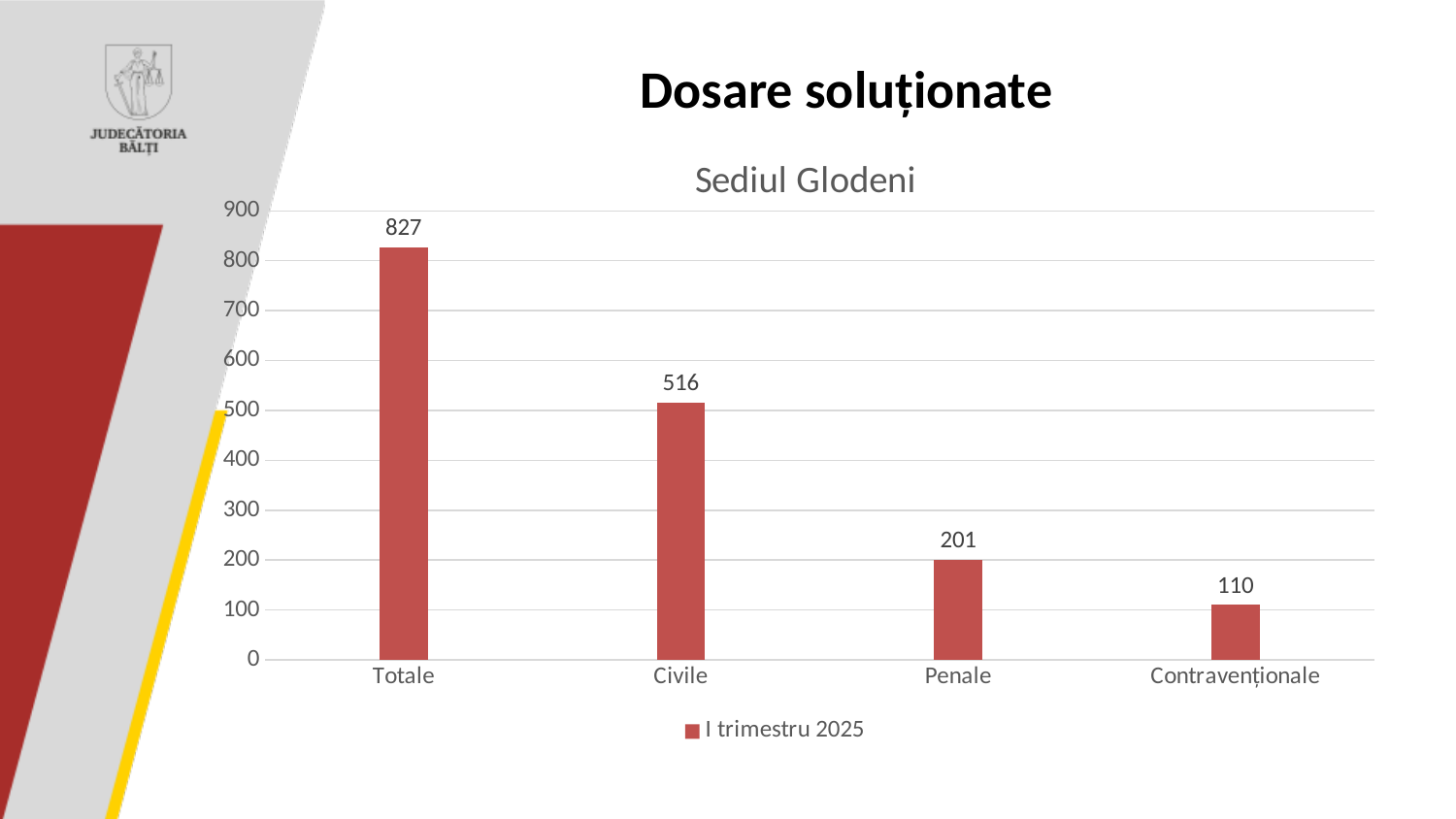
Which category has the lowest value? Contravenționale What is the value for Penale? 201 Which category has the highest value? Totale What is the difference between the values for Civile and Penale? 315 What kind of chart is shown on the slide? bar chart Which is larger, the value for Penale or the value for Contravenționale? Penale How many categories are shown on the x axis? 4 What is the value for Civile? 516 What series does the legend list? I trimestru 2025 What is the value for Contravenționale? 110 What is the value for Totale? 827 Is the value for Civile greater or less than 500? greater